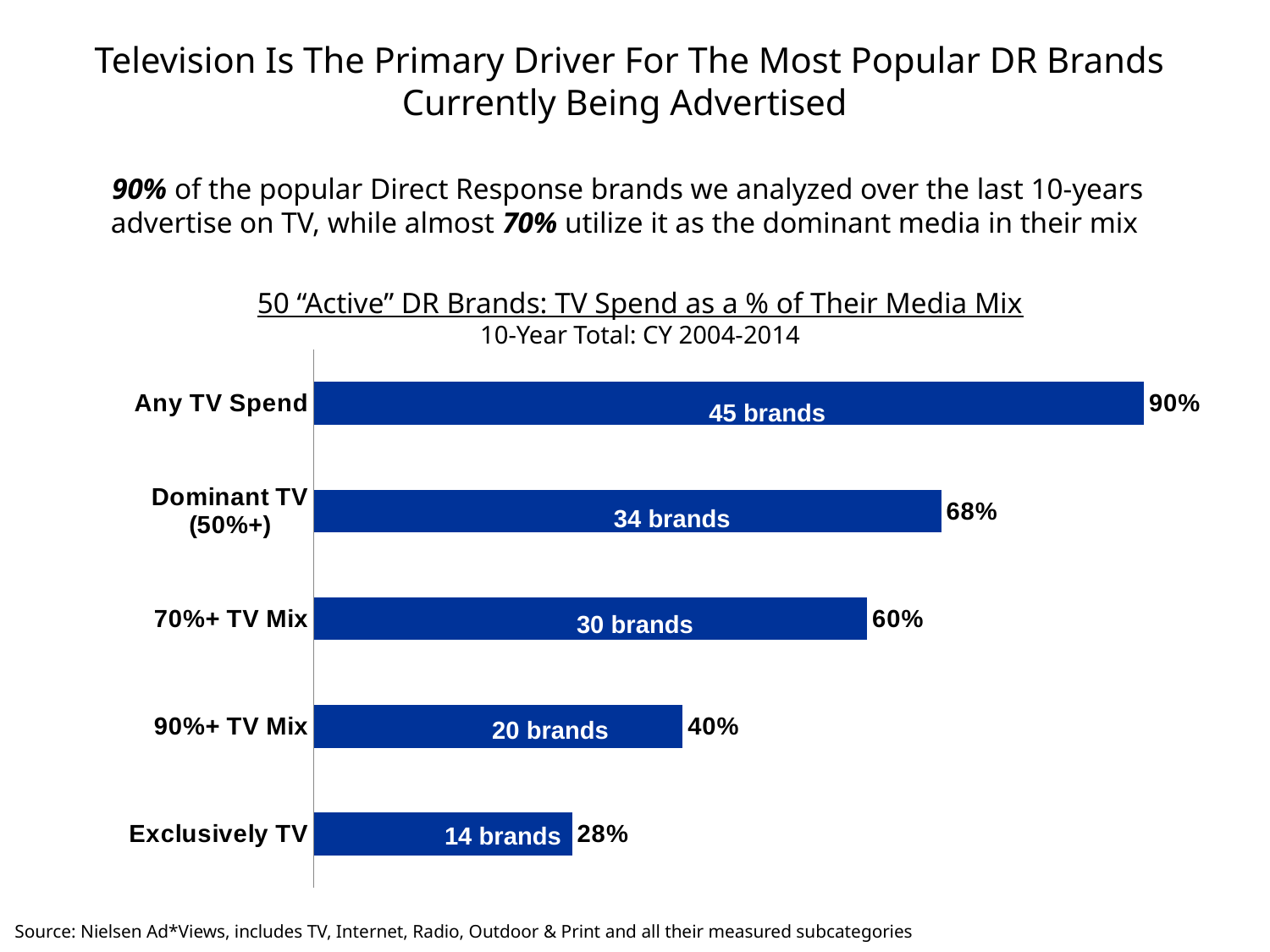
Which category has the highest percentage? Any TV Spend How many brands are labeled on the 90%+ TV Mix bar? 20 brands How many brands are labeled on the Dominant TV (50%+) bar? 34 brands Which is larger, the percentage for 70%+ TV Mix or for 90%+ TV Mix? 70%+ TV Mix How many more brands are in the 70%+ TV Mix category than in the Exclusively TV category? 16 Which category has the lowest percentage? Exclusively TV What is the title of the chart? 50 "Active" DR Brands: TV Spend as a % of Their Media Mix What kind of chart is shown on the slide? Bar chart How many categories are shown in the chart? 5 What percentage is shown for Any TV Spend? 90% What percentage is shown for Exclusively TV? 28% What is the difference in percentage points between Any TV Spend and Dominant TV (50%+)? 22